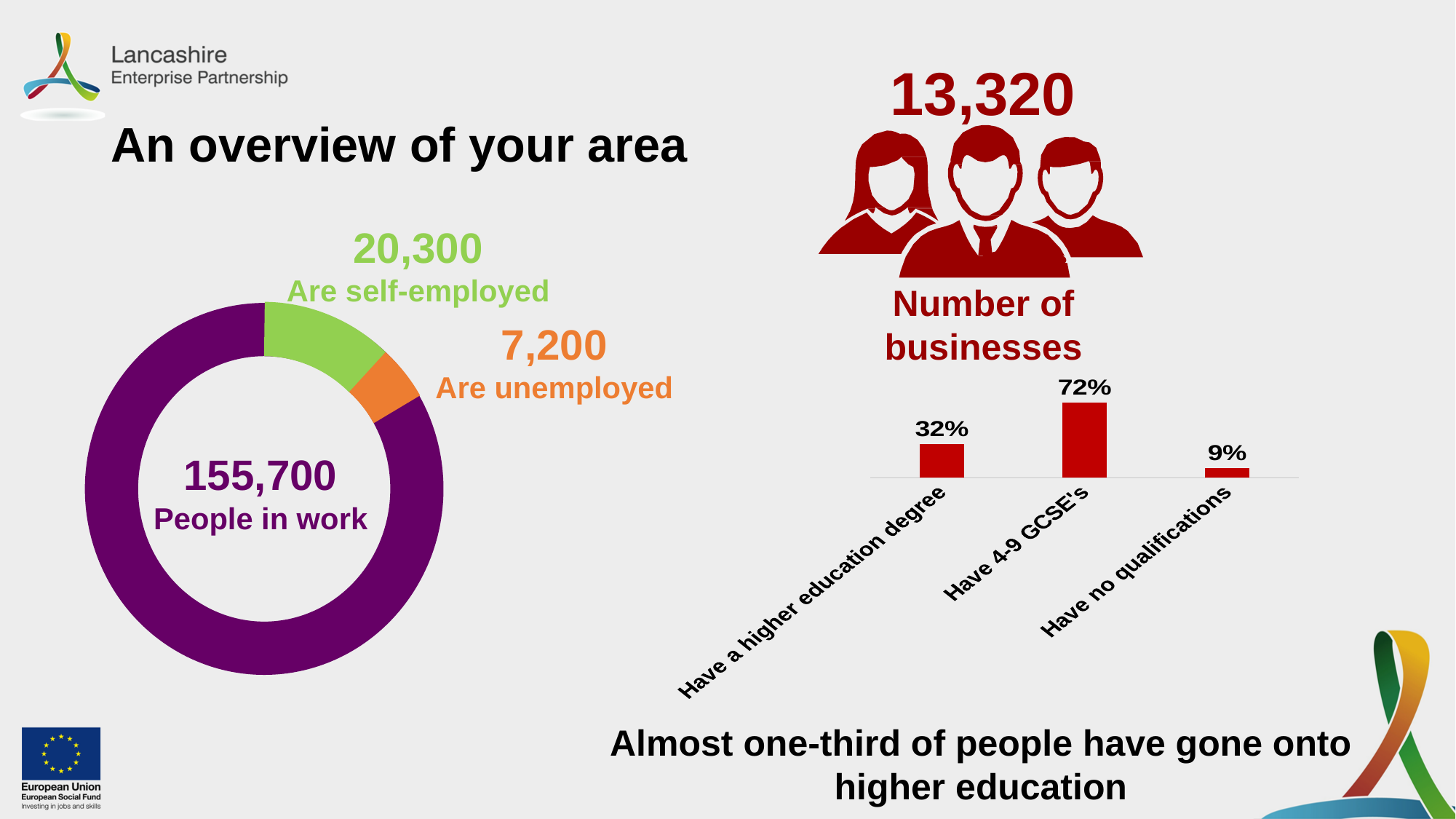
In the bar chart on the right, which category has the highest value? Have 4-9 GCSE's What kind of chart is shown on the right of the slide? Bar chart In the bar chart on the right, what percentage of people have a higher education degree? 32% In the donut chart on the left, how many people are self-employed? 20,300 In the bar chart on the right, which category has the lowest value? Have no qualifications How many categories are shown in the bar chart on the right? 3 In the bar chart on the right, what is the difference between the percentage with 4-9 GCSE's and the percentage with a higher education degree? 40 percentage points In the bar chart on the right, which is larger: the value for 'Have a higher education degree' or 'Have no qualifications'? Have a higher education degree In the bar chart on the right, what percentage of people have no qualifications? 9% In the donut chart on the left, what is the difference between the number of self-employed people and the number of unemployed people? 13,100 In the bar chart on the right, what percentage of people have 4-9 GCSE's? 72% In the donut chart on the left, how many people are unemployed? 7,200